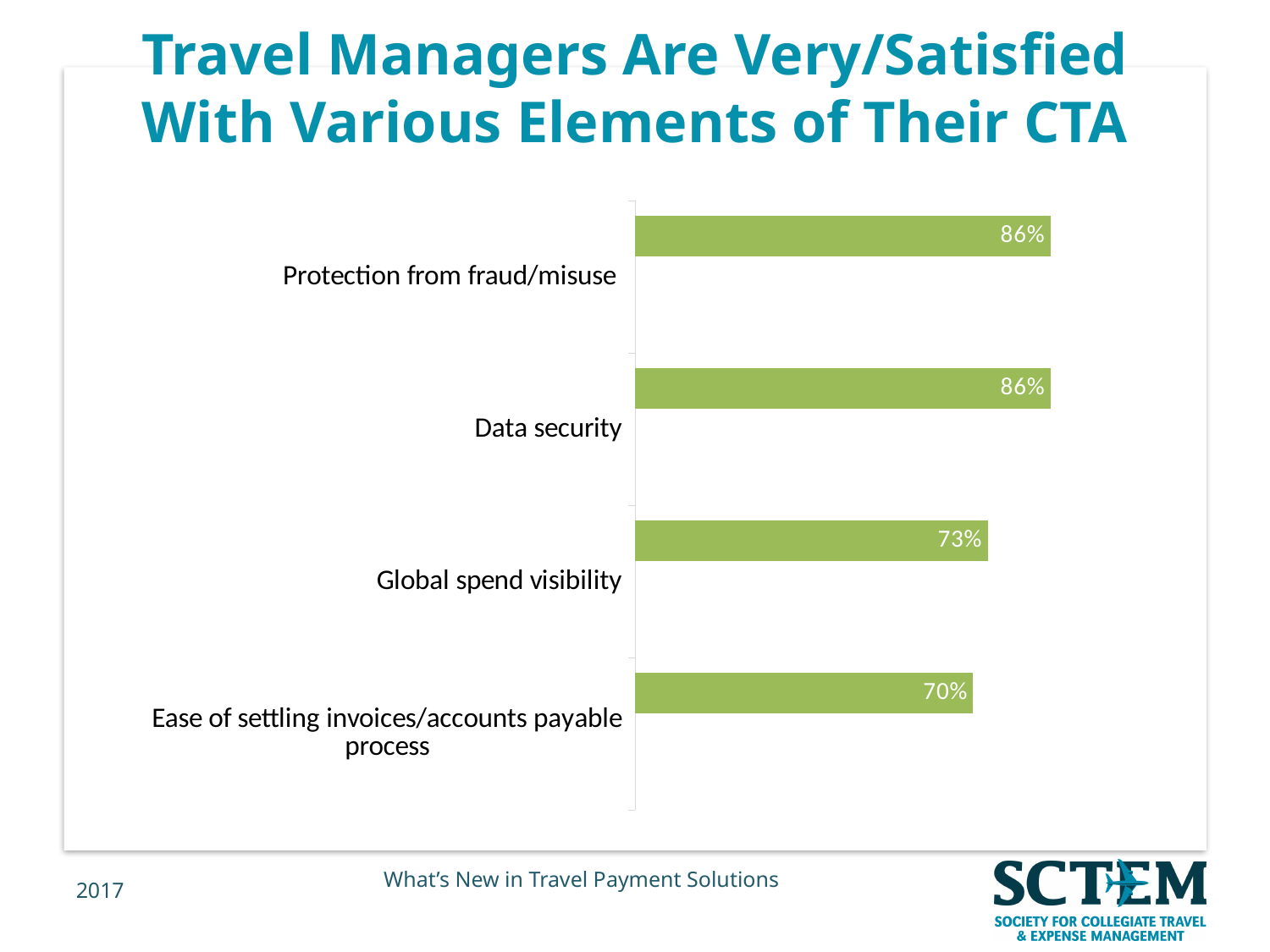
What is the value for Protection from fraud/misuse? 86% What is the value for Ease of settling invoices/accounts payable process? 70% What is the value for Data security? 86% How many categories are shown in the chart? 4 What colour are the bars in the chart? Green Which two categories share the same value of 86%? Protection from fraud/misuse and Data security Which is larger, the value for Data security or the value for Global spend visibility? Data security Which category has the lowest value? Ease of settling invoices/accounts payable process What kind of chart is shown on the slide? Bar chart What is the value for Global spend visibility? 73% What is the difference between the values for Global spend visibility and Ease of settling invoices/accounts payable process? 3% What is the difference between the values for Data security and Global spend visibility? 13%